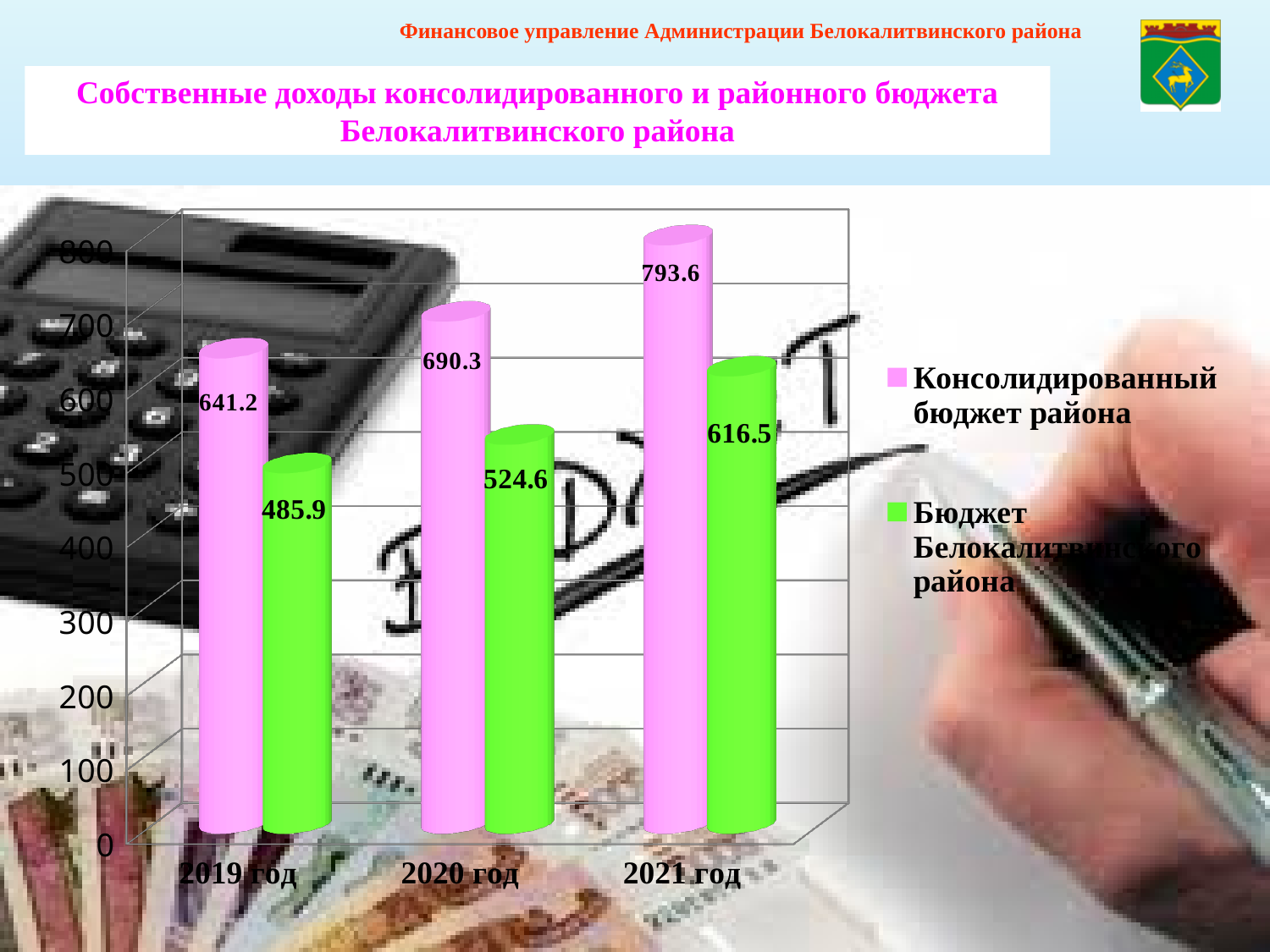
What is the value for Консолидированный бюджет района in 2021 год? 793.6 By how much did Консолидированный бюджет района grow from 2019 год to 2021 год? 152.4 What is the value for Бюджет Белокалитвинского района in 2019 год? 485.9 Which year has the highest value for Бюджет Белокалитвинского района? 2021 год How many years are shown on the x axis? 3 Do the values for Бюджет Белокалитвинского района rise or fall from 2019 год to 2021 год? Rise How many series does the legend list? 2 What kind of chart is shown on the slide? Bar chart Which year has the lowest value for Консолидированный бюджет района? 2019 год What is the value for Консолидированный бюджет района in 2020 год? 690.3 What is the difference between Консолидированный бюджет района and Бюджет Белокалитвинского района in 2021 год? 177.1 Which is larger in 2020 год: Консолидированный бюджет района or Бюджет Белокалитвинского района? Консолидированный бюджет района